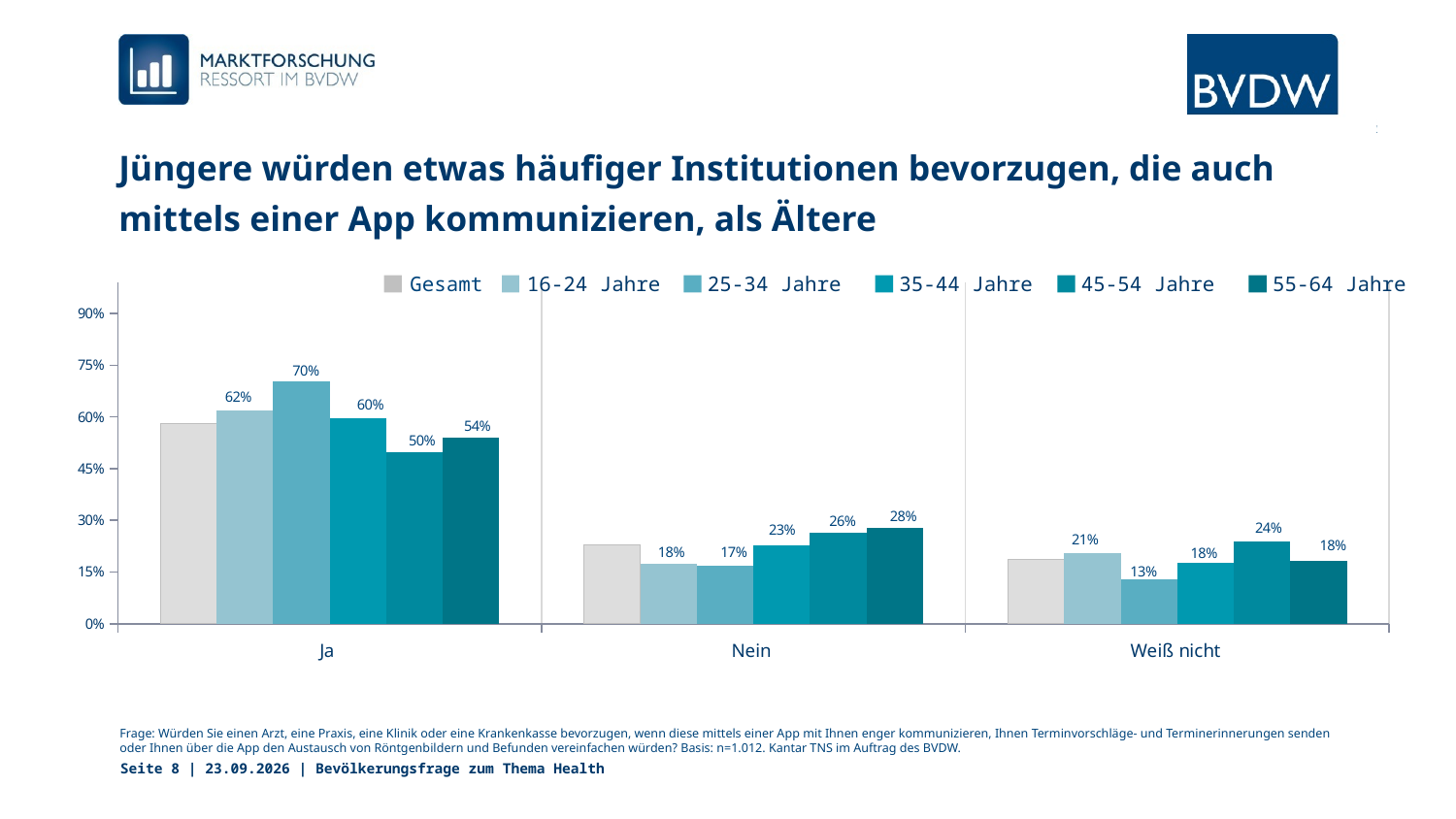
What kind of chart is shown on the slide? bar chart Among the labelled age groups, which has the highest value in the Ja category? 25-34 Jahre How many categories are shown on the x axis? 3 What is the value for 45-54 Jahre in the Nein category? 26% What is the value for 25-34 Jahre in the Ja category? 70% How many series does the legend list? 6 What is the difference between the 16-24 Jahre and 55-64 Jahre values in the Ja category? 8% Among the labelled age groups, which has the lowest value in the Weiß nicht category? 25-34 Jahre Is the value for Gesamt in the Nein category greater or less than 30%? less Is the value for Gesamt in the Ja category greater or less than 45%? greater What is the value for 25-34 Jahre in the Weiß nicht category? 13% In the Nein category, which is larger: the value for 16-24 Jahre or for 55-64 Jahre? 55-64 Jahre